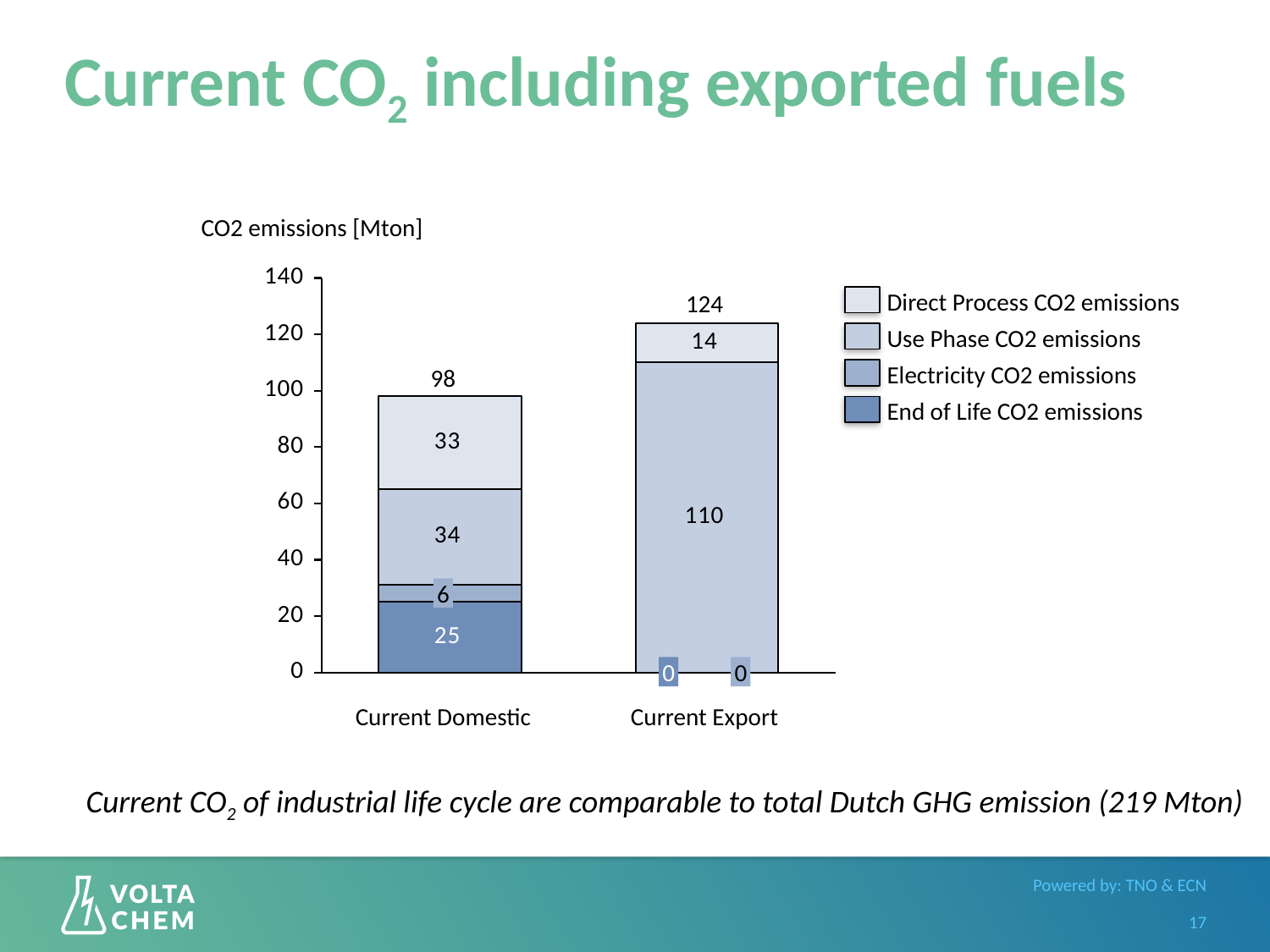
What is the End of Life CO2 emissions value for Current Domestic? 25 What is the Use Phase CO2 emissions value for Current Export? 110 What is the Electricity CO2 emissions value for Current Domestic? 6 What is the Direct Process CO2 emissions value for Current Export? 14 What is the Direct Process CO2 emissions value for Current Domestic? 33 What is the total CO2 emissions value shown above the Current Export bar? 124 How many series does the legend list? 4 What kind of chart is shown on the slide? Stacked bar chart Which category has the higher total CO2 emissions, Current Domestic or Current Export? Current Export How many categories are shown on the x axis? 2 What is the total CO2 emissions value shown above the Current Domestic bar? 98 What is the difference between the total CO2 emissions of Current Export and Current Domestic? 26